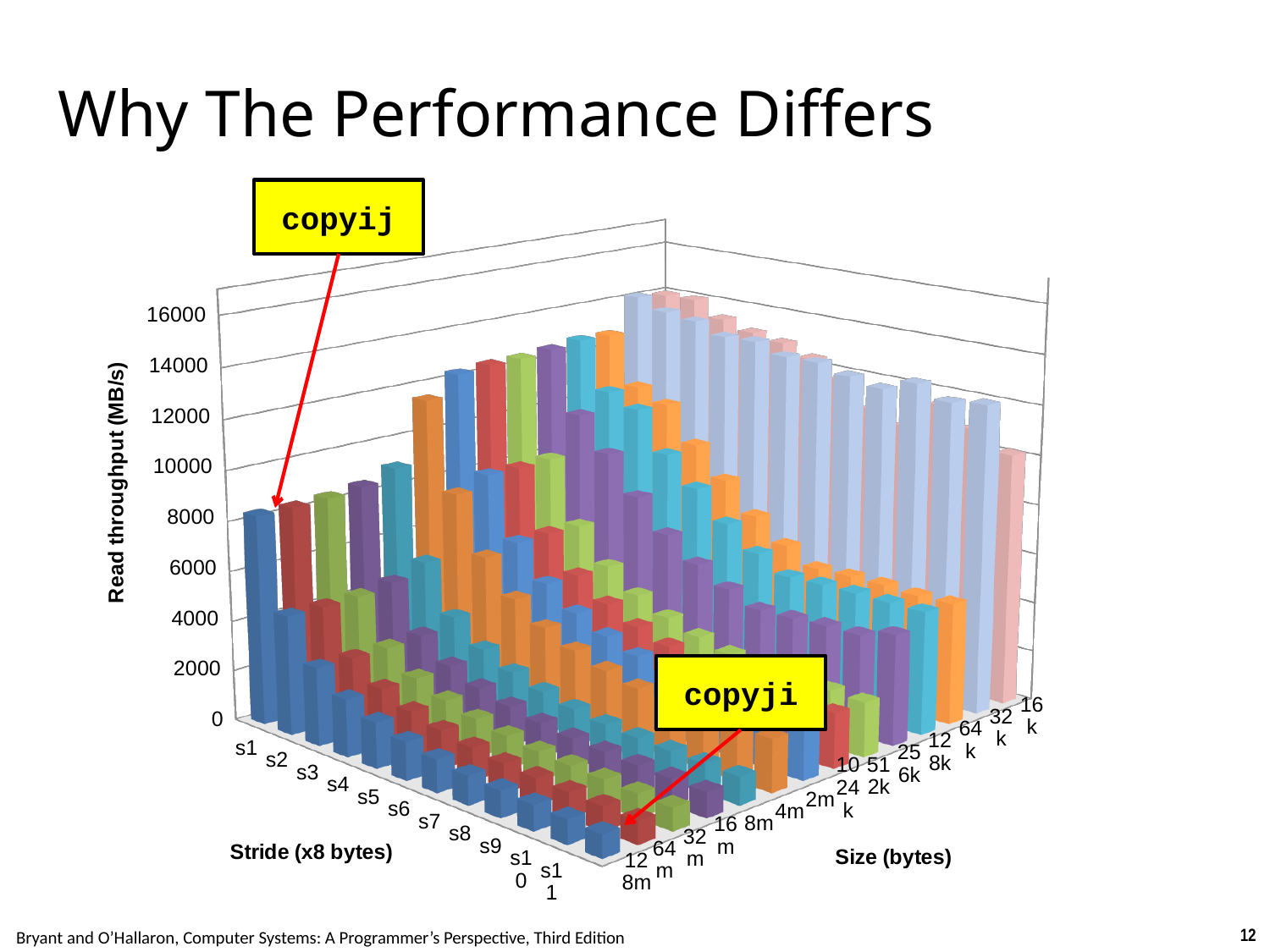
Is the read throughput for stride s1 at size 128m greater or less than 6000? greater Is the read throughput for stride s1 at size 32k greater or less than 12000? greater Which stride has the highest read throughput at size 128m, s1 or s11? s1 What is the label of the stride axis? Stride (x8 bytes) Is the read throughput for stride s11 at size 128m greater or less than 2000? less At size 128m, does read throughput rise or fall as the stride increases from s1 to s11? fall What kind of chart is shown on the slide? 3D bar chart How many stride categories (s1 through s11) are plotted along the stride axis? 11 What is the label of the vertical axis? Read throughput (MB/s) What is the highest tick value shown on the Read throughput axis? 16000 How many size categories are plotted along the Size (bytes) axis? 14